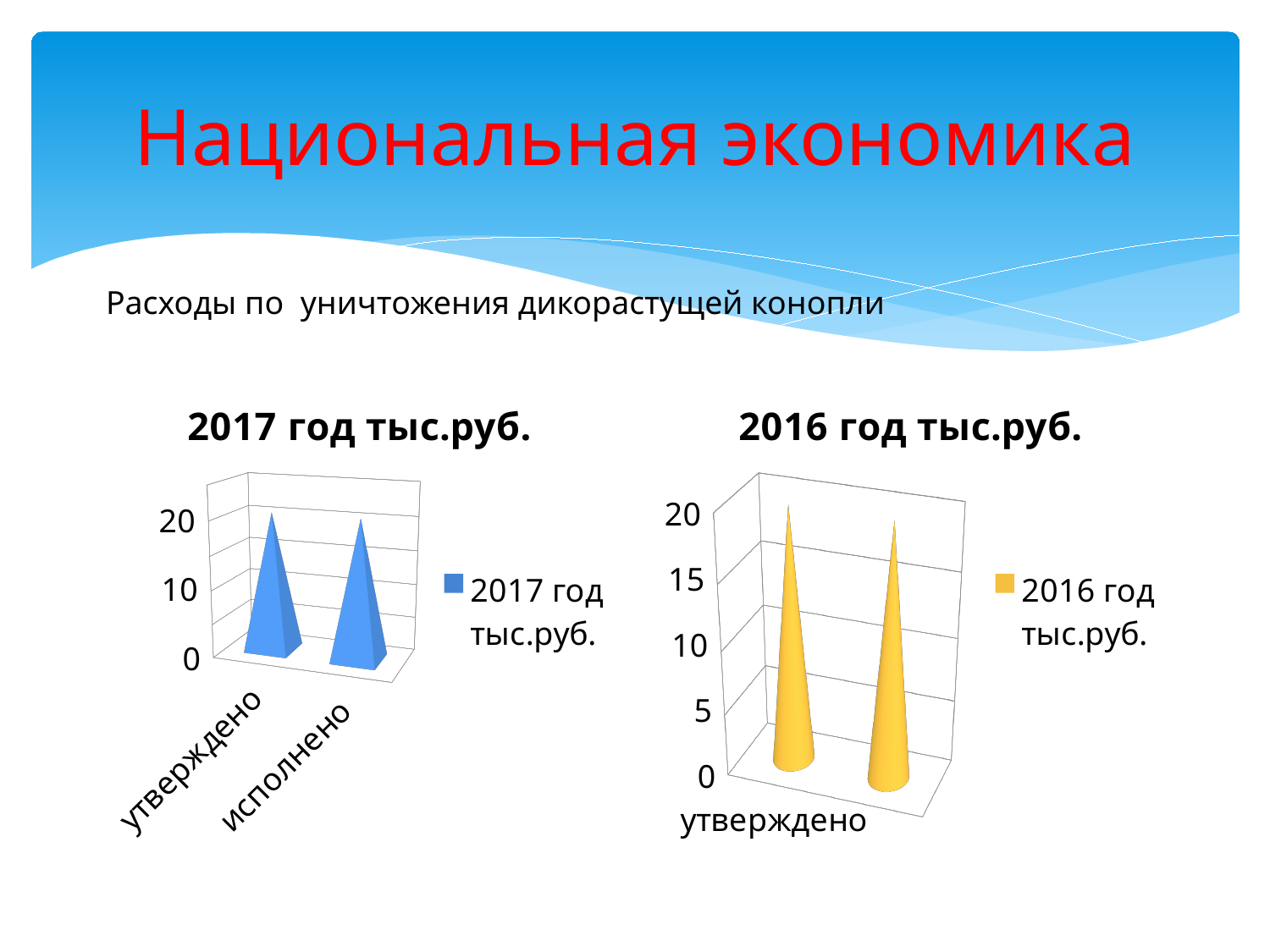
What is the legend entry of the left chart titled "2017 год тыс.руб."? 2017 год тыс.руб. What kind of chart is the right chart titled "2016 год тыс.руб."? bar chart How many series does the legend of the chart "2017 год тыс.руб." list? 1 In the chart "2017 год тыс.руб.", is the value for исполнено greater or less than 10? greater In the chart "2016 год тыс.руб.", is the value for утверждено greater or less than 15? greater What colour are the bars in the chart "2016 год тыс.руб."? yellow What kind of chart is the left chart titled "2017 год тыс.руб."? bar chart In the chart "2017 год тыс.руб.", is the value for утверждено greater or less than 10? greater In the chart "2016 год тыс.руб.", how many bars are plotted? 2 In the chart "2017 год тыс.руб.", how many categories are shown on the x axis? 2 How many series does the legend of the chart "2016 год тыс.руб." list? 1